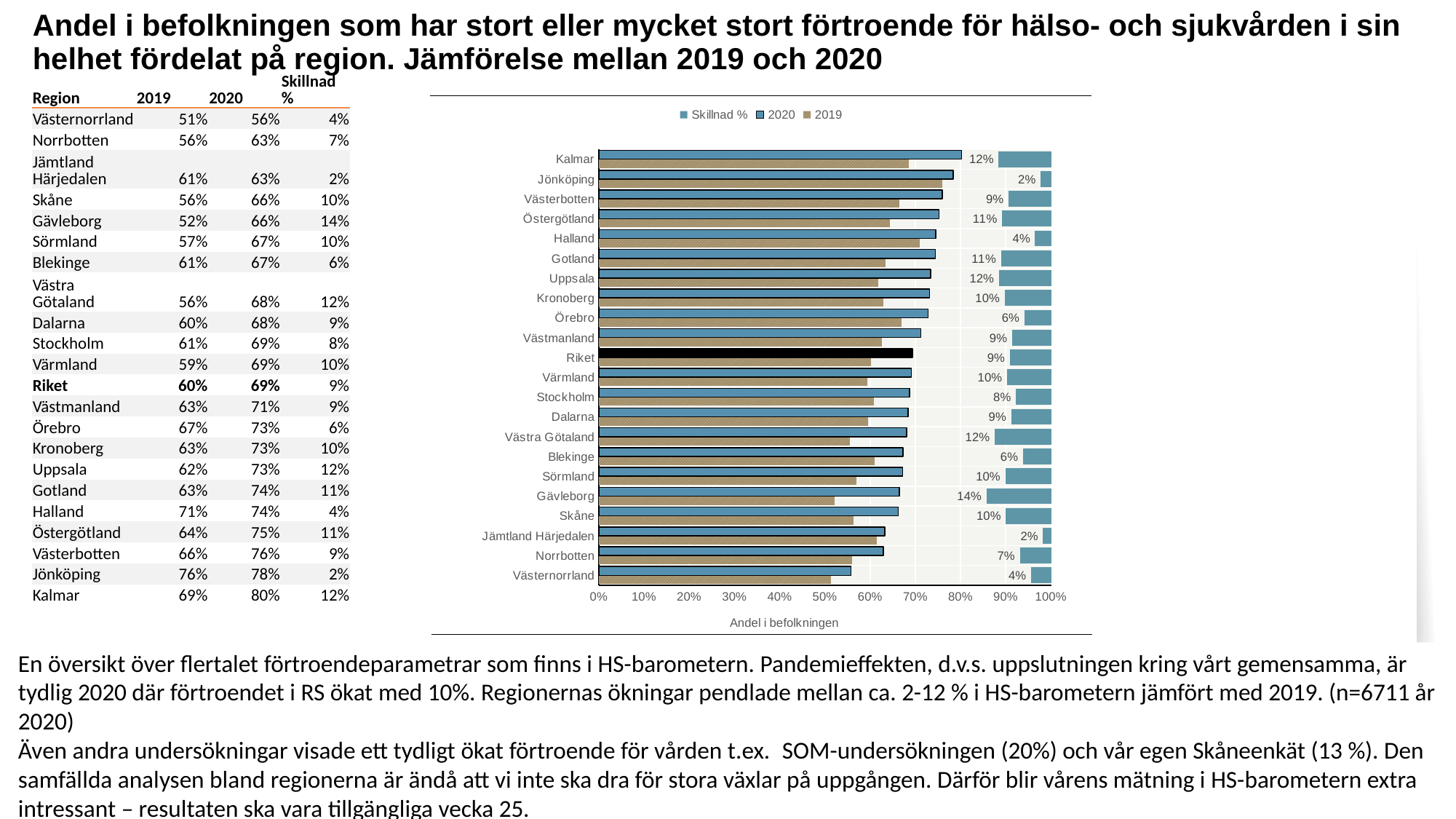
What kind of chart is shown on the slide? bar chart How many series does the chart legend list? 3 Which region has the shortest 2020 bar? Västernorrland Which region has the highest Skillnad % value? Gävleborg What is the difference between the Skillnad % values for Gävleborg and Kalmar? 2% What is the Skillnad % value for Kalmar? 12% What is the Skillnad % value for Riket? 9% Which region has the longest 2020 bar? Kalmar What is the Skillnad % value for Gävleborg? 14% Which has the larger Skillnad % value, Kalmar or Halland? Kalmar Is the 2020 value for Kalmar greater or less than 70%? greater How many regions (including Riket) are plotted on the chart? 22